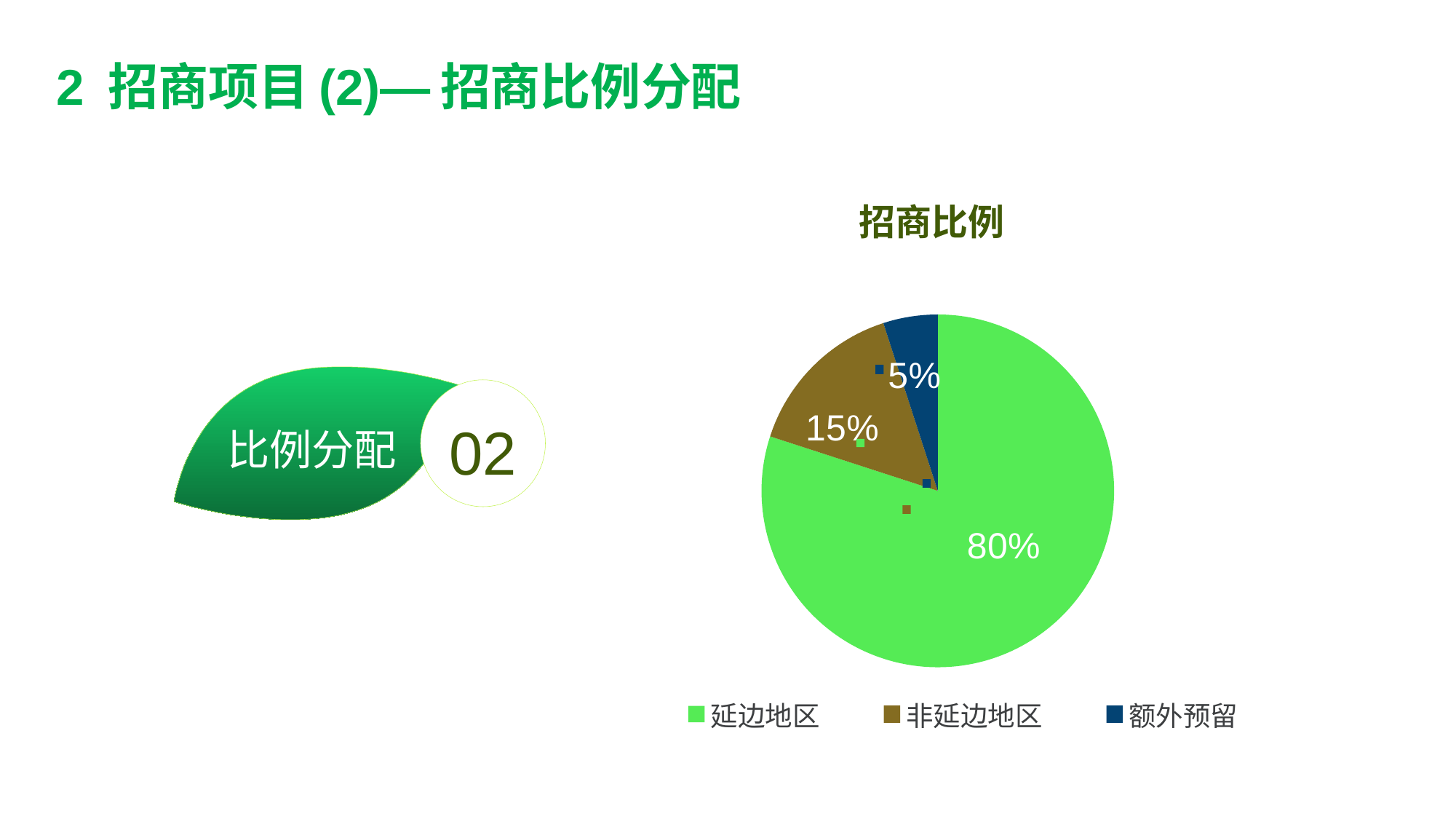
What is the title of the chart? 招商比例 How many categories does the pie chart have? 3 What share of the pie does 延边地区 have? 80% What colour is the slice for 额外预留? dark blue How many entries does the legend list? 3 What type of chart is shown on the slide? pie chart Which is larger, the share of 非延边地区 or the share of 额外预留? 非延边地区 Which category has the smallest slice of the pie? 额外预留 What share of the pie does 非延边地区 have? 15% Which category has the largest slice of the pie? 延边地区 What share of the pie does 额外预留 have? 5% What is the difference between the shares of 延边地区 and 非延边地区? 65%